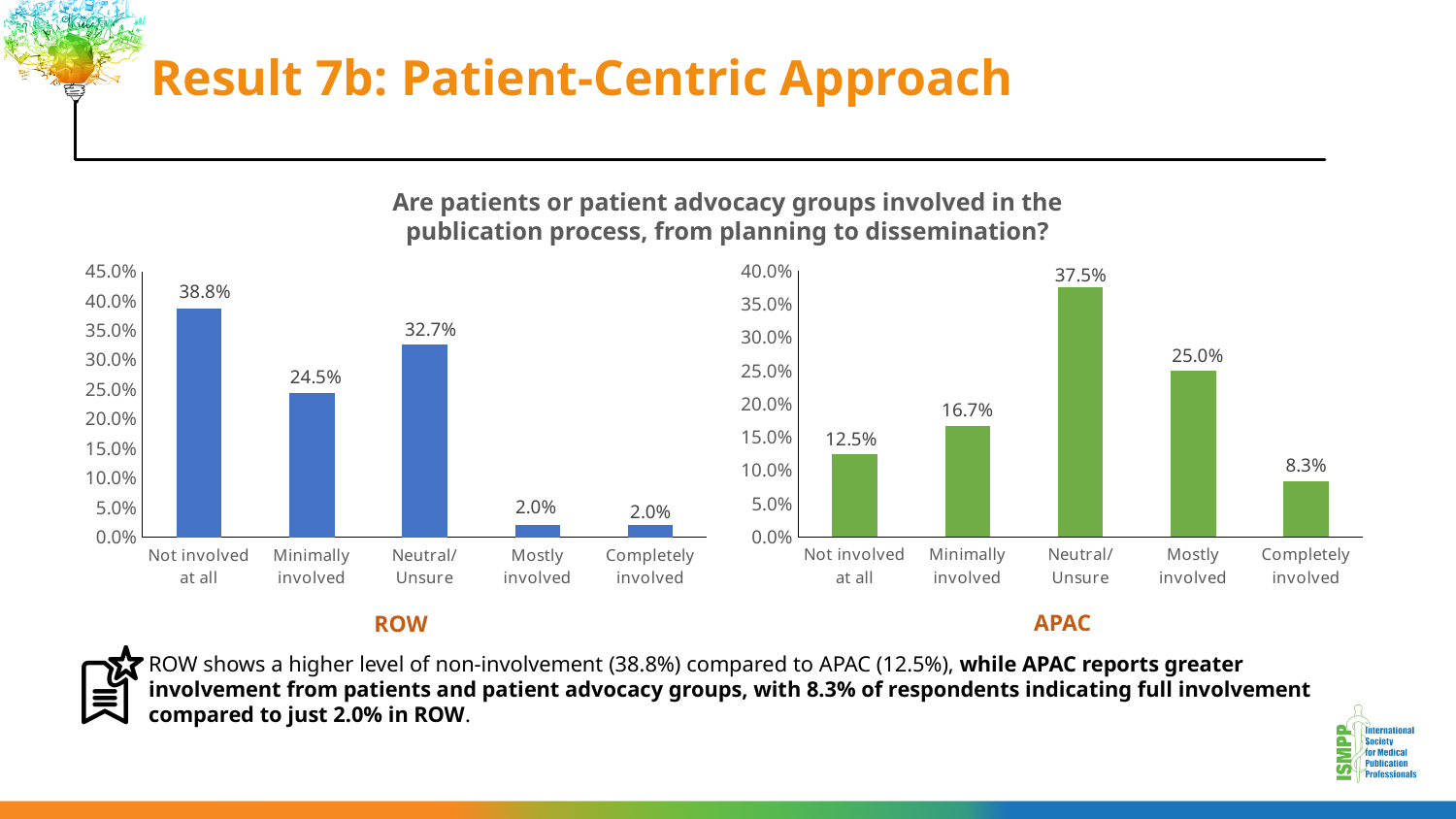
In the ROW chart, which category has the highest value? Not involved at all What type of chart is the ROW chart? Bar chart In the APAC chart, which category has the lowest value? Completely involved In the ROW chart, is the value for 'Neutral/Unsure' greater or less than 30.0%? greater In the APAC chart, what is the value for 'Completely involved'? 8.3% Which is larger: 'Mostly involved' in the ROW chart or 'Mostly involved' in the APAC chart? APAC What colour are the bars in the APAC chart? Green In the ROW chart, what percentage of respondents answered 'Not involved at all'? 38.8% In the APAC chart, what is the difference between 'Neutral/Unsure' and 'Mostly involved'? 12.5% How many categories are shown in the APAC chart? 5 In the APAC chart, what percentage of respondents answered 'Neutral/Unsure'? 37.5% In the ROW chart, what is the difference between 'Not involved at all' and 'Minimally involved'? 14.3%